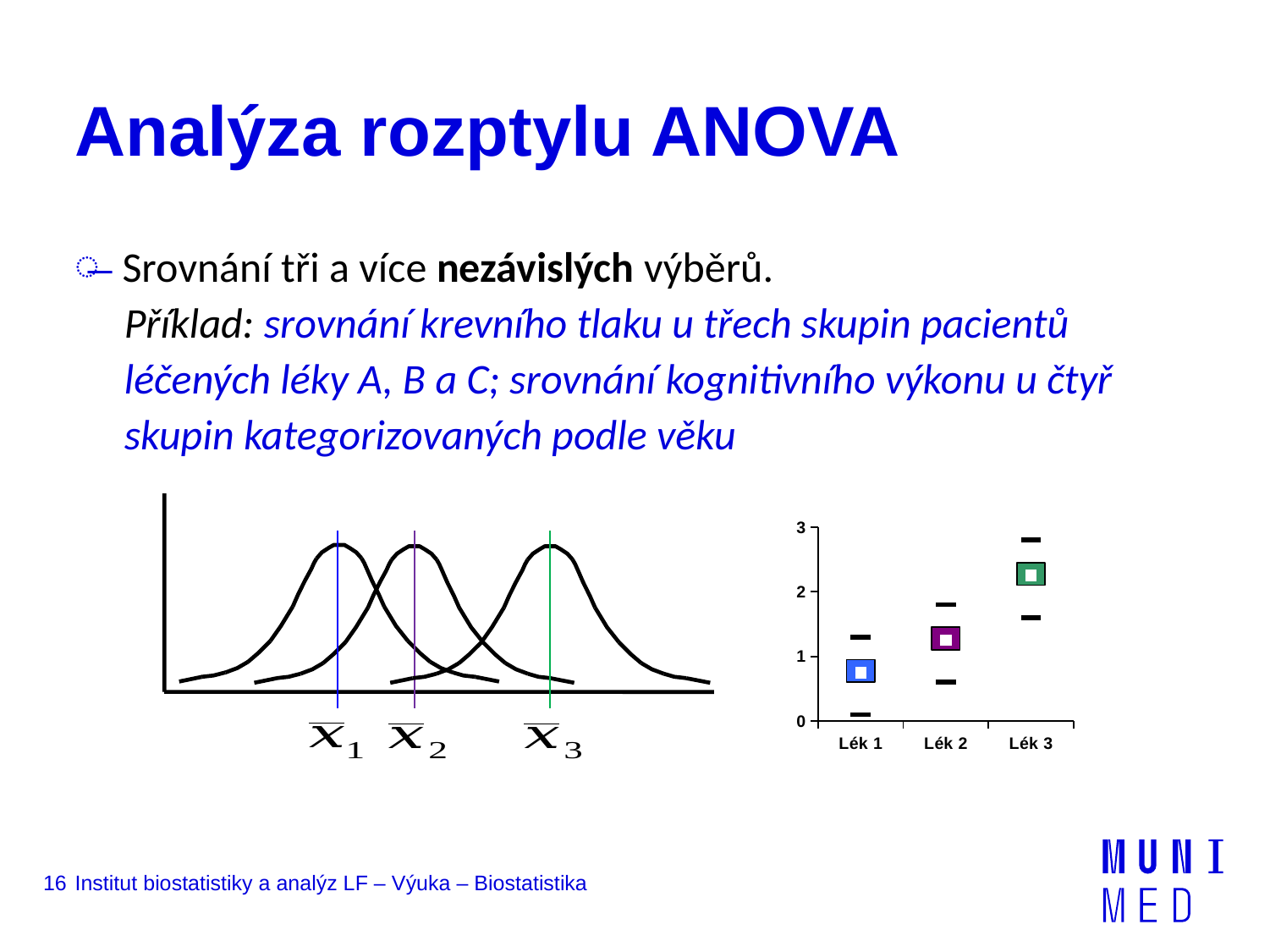
On the right-hand chart, how many categories are shown on the x axis? 3 On the right-hand chart, which category has the highest central (box) value? Lék 3 On the left-hand chart, which labelled mean lies furthest to the right? x̄3 On the right-hand chart, is the central (box) value for Lék 3 greater or less than 2? greater On the right-hand chart, is the upper whisker for Lék 3 greater or less than 3? less On the right-hand chart, is the central (box) value for Lék 2 greater or less than 1? greater On the right-hand chart, do the central values rise or fall from Lék 1 to Lék 3? rise On the right-hand chart, which category has the lowest central (box) value? Lék 1 On the left-hand chart, how many distribution curves are drawn? 3 On the right-hand chart, what is the highest tick value shown on the y axis? 3 On the right-hand chart, which has the larger central (box) value, Lék 1 or Lék 2? Lék 2